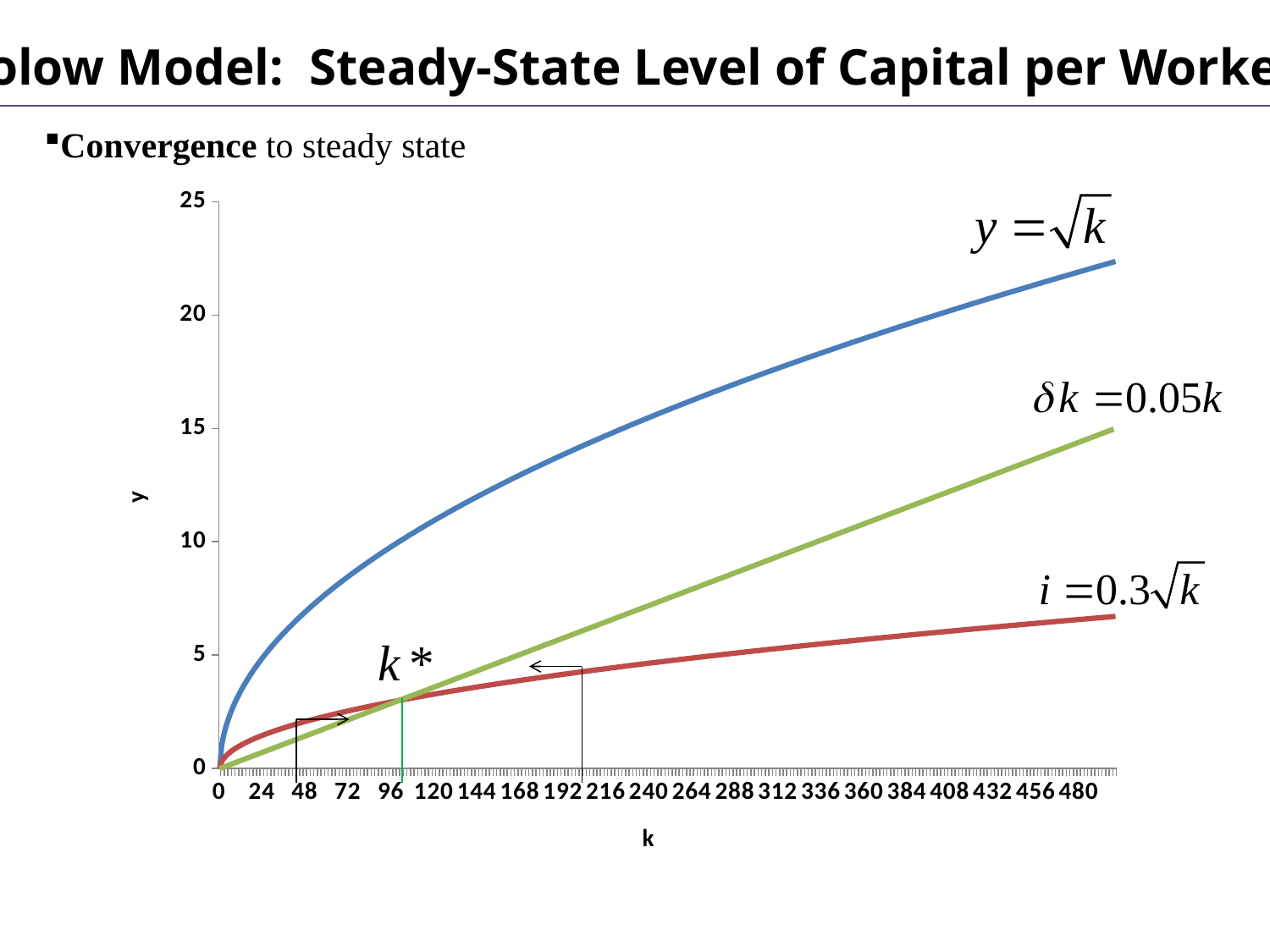
Is the value of the y = √k curve at k = 480 greater or less than 20? greater Is the value of the δk = 0.05k curve at k = 480 greater or less than 10? greater Which curve has the lowest value at k = 480? i = 0.3√k How many curves are plotted on the chart? 3 At k = 240, which is larger: the y = √k curve or the i = 0.3√k curve? y = √k What is the label of the vertical axis of the chart? y What kind of chart is shown on the slide? line chart What is the label of the horizontal axis of the chart? k At k = 240, which is larger: the δk = 0.05k curve or the i = 0.3√k curve? δk = 0.05k Does the y = √k curve rise or fall as k increases? rise Is the value of the i = 0.3√k curve at k = 480 greater or less than 10? less Which curve has the highest value at k = 480? y = √k